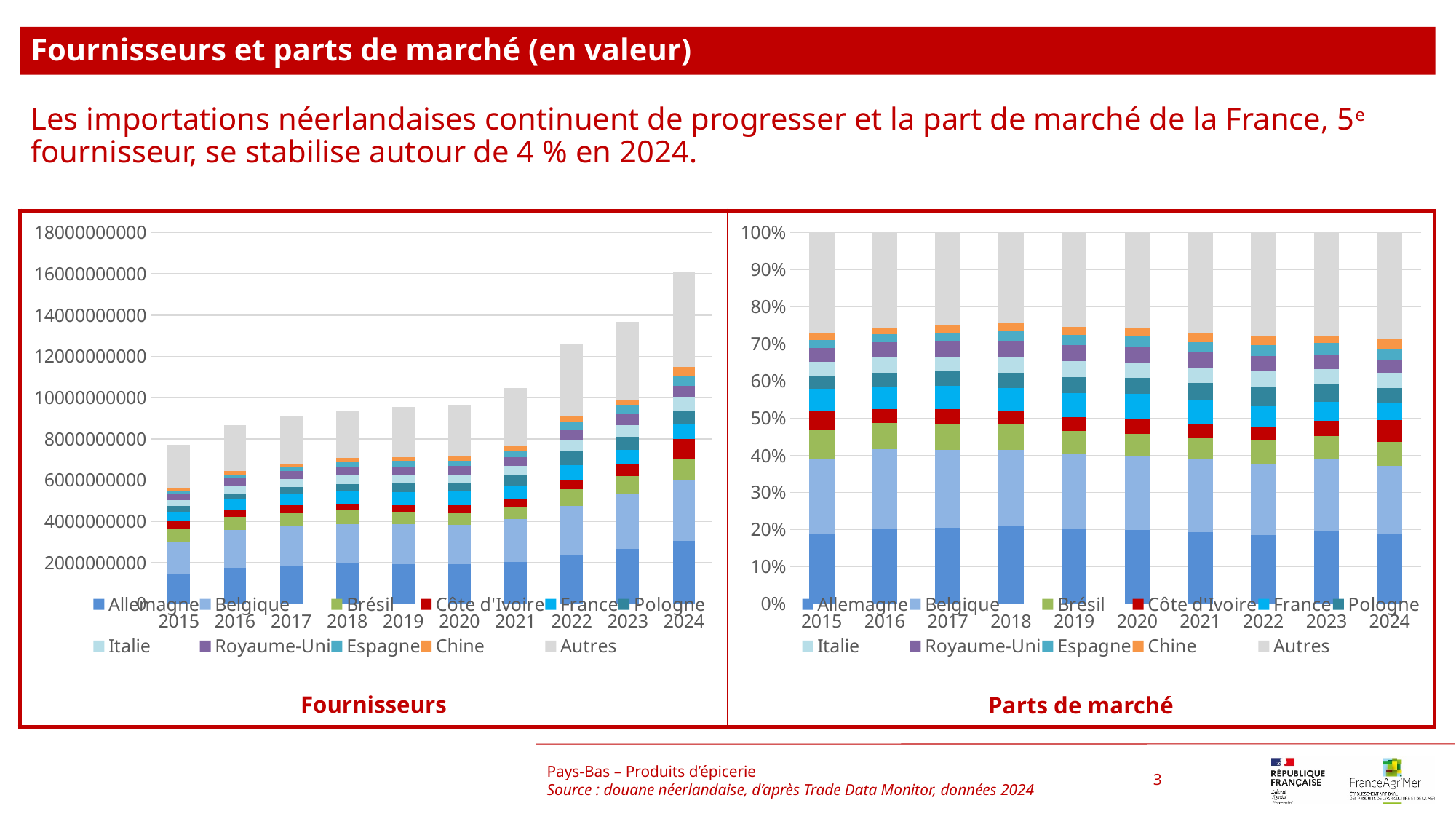
In the 'Fournisseurs' chart, do the total bars generally rise or fall from 2015 to 2024? rise In the 'Fournisseurs' chart, which year has the lowest total bar? 2015 In the 'Parts de marché' chart, how many series does the legend list? 11 In the 'Fournisseurs' chart, which total bar is larger, 2022 or 2023? 2023 In the 'Fournisseurs' chart, which year has the highest total bar? 2024 In the 'Fournisseurs' chart, which series is shown at the top of each bar? Autres What kind of chart is the 'Fournisseurs' chart on the left? stacked bar chart In the 'Parts de marché' chart, which series is shown at the bottom of each bar? Allemagne In the 'Fournisseurs' chart, is the total for 2015 greater or less than 10000000000? less In the 'Fournisseurs' chart, how many years are shown on the x axis? 10 What kind of chart is the 'Parts de marché' chart on the right? 100% stacked bar chart In the 'Fournisseurs' chart, is the total for 2024 greater or less than 14000000000? greater